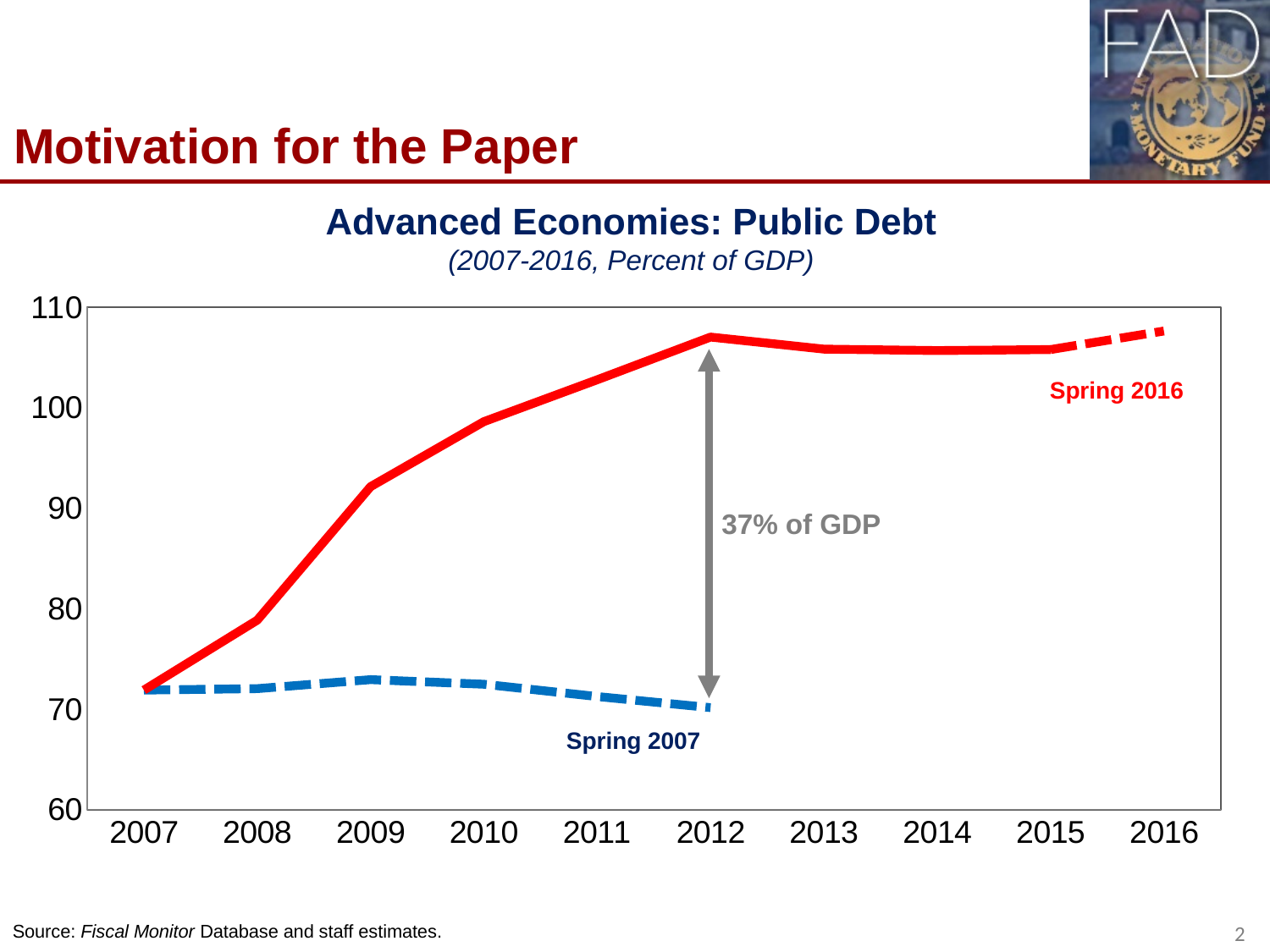
Is the value of the Spring 2016 line in 2010 greater or less than 90? greater What kind of chart is shown on the slide? line chart In what units are the values on the chart expressed, according to the subtitle? Percent of GDP Is the value of the Spring 2007 line in 2012 greater or less than 80? less What is the title of the chart? Advanced Economies: Public Debt In which year is the Spring 2016 line at its lowest? 2007 How many years are shown on the x axis? 10 In 2011, which line is higher: Spring 2016 or Spring 2007? Spring 2016 Is the value of the Spring 2016 line in 2008 greater or less than 80? less Does the Spring 2016 line rise or fall between 2007 and 2012? rise What is the labelled gap between the Spring 2016 and Spring 2007 lines in 2012? 37% of GDP How many series are plotted on the chart? 2